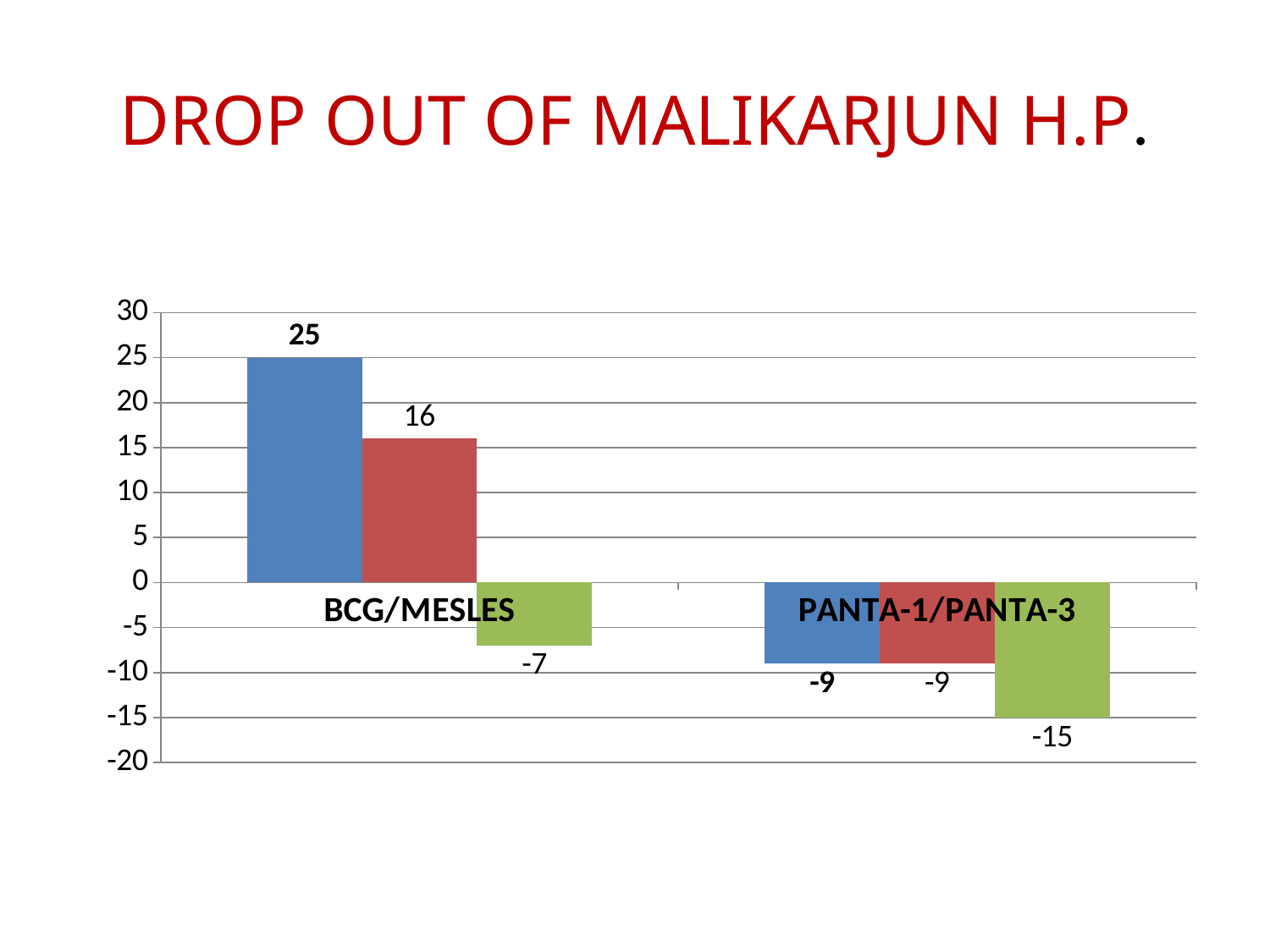
What type of chart is shown on the slide? Bar chart What is the value of the red bar for BCG/MESLES? 16 What is the title of the slide? DROP OUT OF MALIKARJUN H.P. What is the value of the blue bar for BCG/MESLES? 25 What is the value of the blue bar for PANTA-1/PANTA-3? -9 Which bar has the lowest value on the chart? The green bar for PANTA-1/PANTA-3 (-15) Which bar has the highest value on the chart? The blue bar for BCG/MESLES (25) How many categories are shown on the x axis? 2 Which is larger, the green bar for BCG/MESLES or the green bar for PANTA-1/PANTA-3? The green bar for BCG/MESLES What is the difference between the blue and red bars for BCG/MESLES? 9 What is the value of the green bar for BCG/MESLES? -7 What is the value of the green bar for PANTA-1/PANTA-3? -15